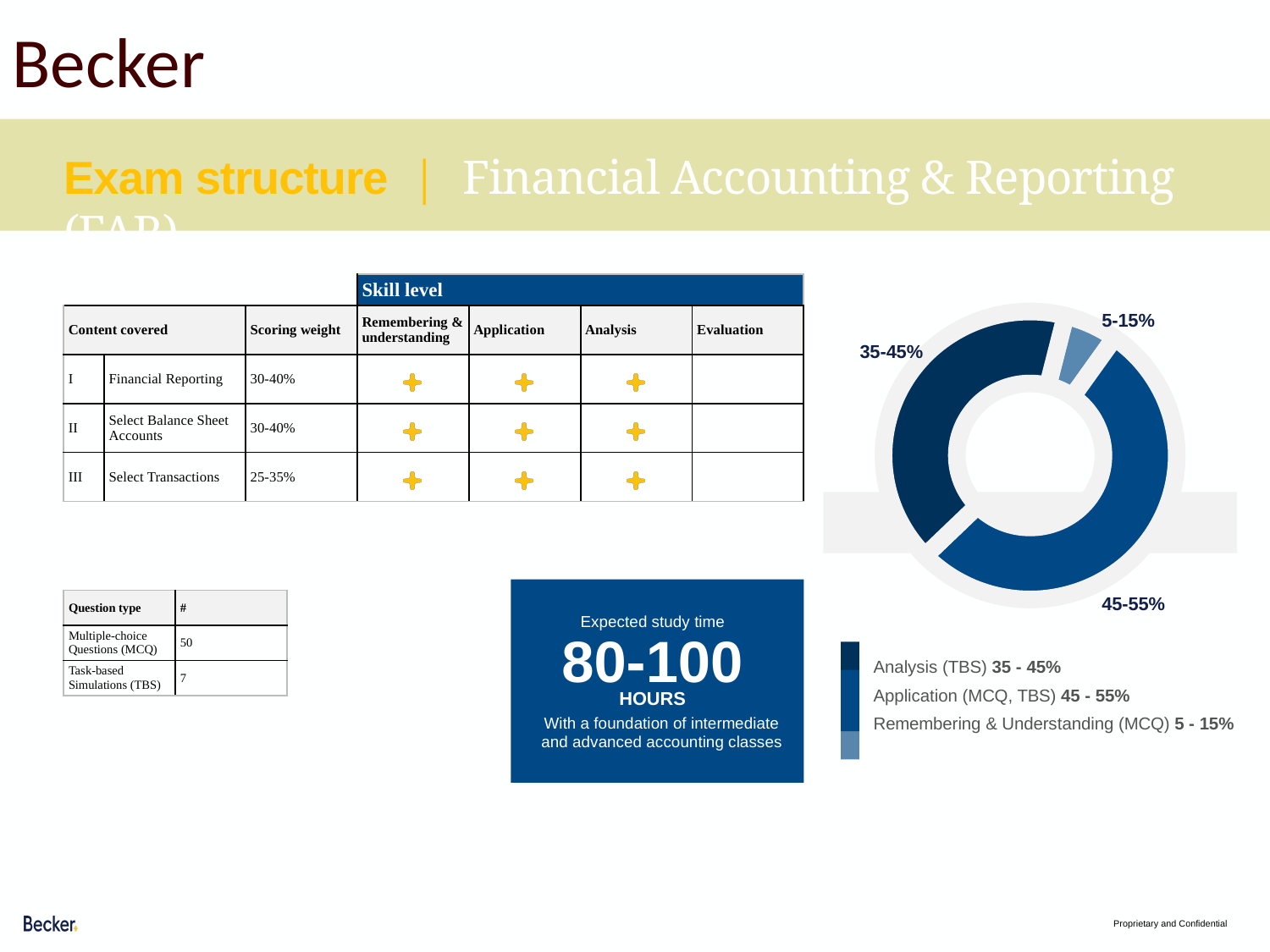
What range is shown for the Remembering & Understanding (MCQ) slice of the donut chart? 5 - 15% Which skill level has the largest slice in the donut chart? Application (MCQ, TBS) What range is shown for the Application (MCQ, TBS) slice of the donut chart? 45 - 55% What kind of chart is shown on the right of the slide? Donut chart How many slices does the donut chart have? 3 In the donut chart, which slice is larger: Analysis (TBS) or Remembering & Understanding (MCQ)? Analysis (TBS) Which skill level has the smallest slice in the donut chart? Remembering & Understanding (MCQ) In the donut chart, which slice is larger: Application (MCQ, TBS) or Analysis (TBS)? Application (MCQ, TBS) What range is shown for the Analysis (TBS) slice of the donut chart? 35 - 45% How many entries does the legend below the donut chart list? 3 Which legend entry of the donut chart is shown in the lightest blue colour? Remembering & Understanding (MCQ) Which legend entry of the donut chart is shown in the darkest blue colour? Analysis (TBS)